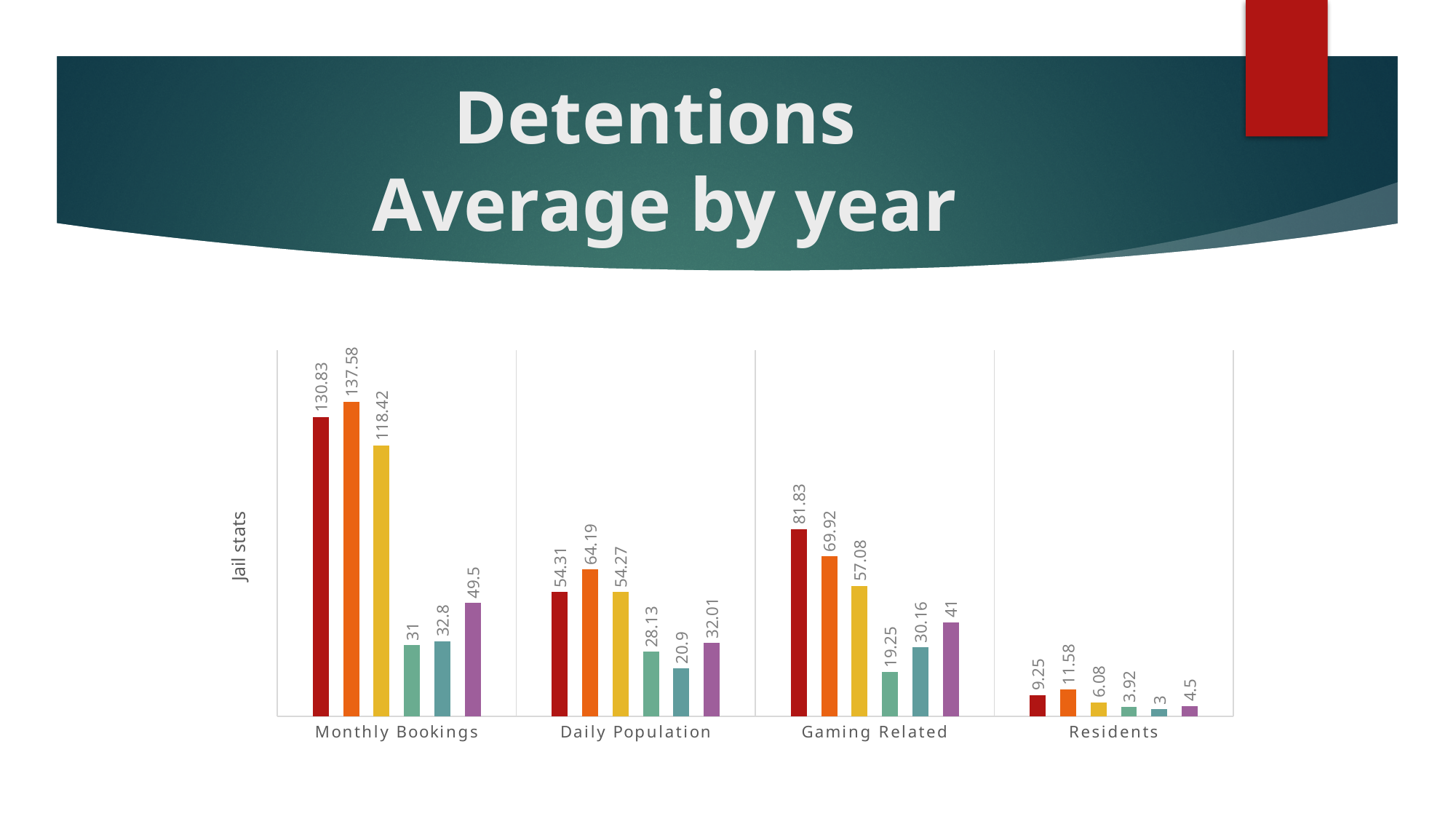
What is the value of the orange bar for Monthly Bookings? 137.58 What is the value of the red bar for Gaming Related? 81.83 Which bar has the highest value in the Monthly Bookings category? the orange bar (137.58) What is the label on the vertical axis of the chart? Jail stats What is the difference between the orange bar and the red bar for Daily Population? 9.88 How many categories are shown on the x axis of the chart? 4 What kind of chart is shown on the slide? bar chart Which is larger for Residents: the red bar or the orange bar? the orange bar (11.58) What is the value of the teal bar for Residents? 3 What is the value of the purple bar for Daily Population? 32.01 How many bars are plotted for each category in the chart? 6 Which bar has the lowest value in the Gaming Related category? the green bar (19.25)